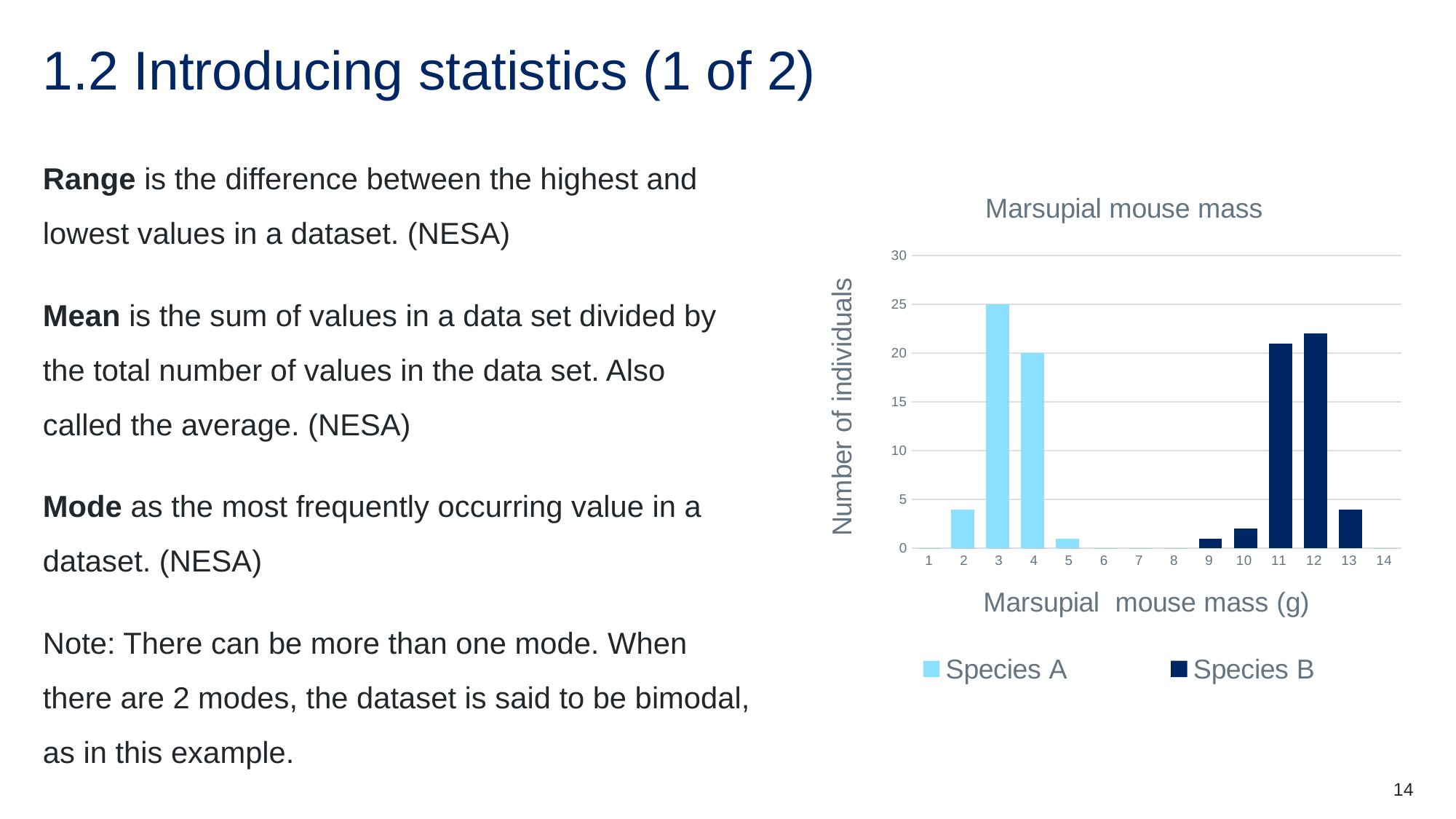
What are the two series named in the legend? Species A and Species B How many series does the chart legend list? 2 Is the number of Species A individuals at 2 g greater or less than 5? less What is the number of individuals for Species A at a mass of 4 g? 20 How many mass categories are shown on the x axis? 14 At which mass does Species A have the most individuals? 3 What is the difference between the number of Species A individuals at 3 g and at 4 g? 5 What type of chart is shown on the slide? Bar chart What is the number of individuals for Species A at a mass of 3 g? 25 Which mass has the tallest bar in the whole chart? 3 What is the title of the chart? Marsupial mouse mass Is the number of Species B individuals at 11 g greater or less than 20? greater